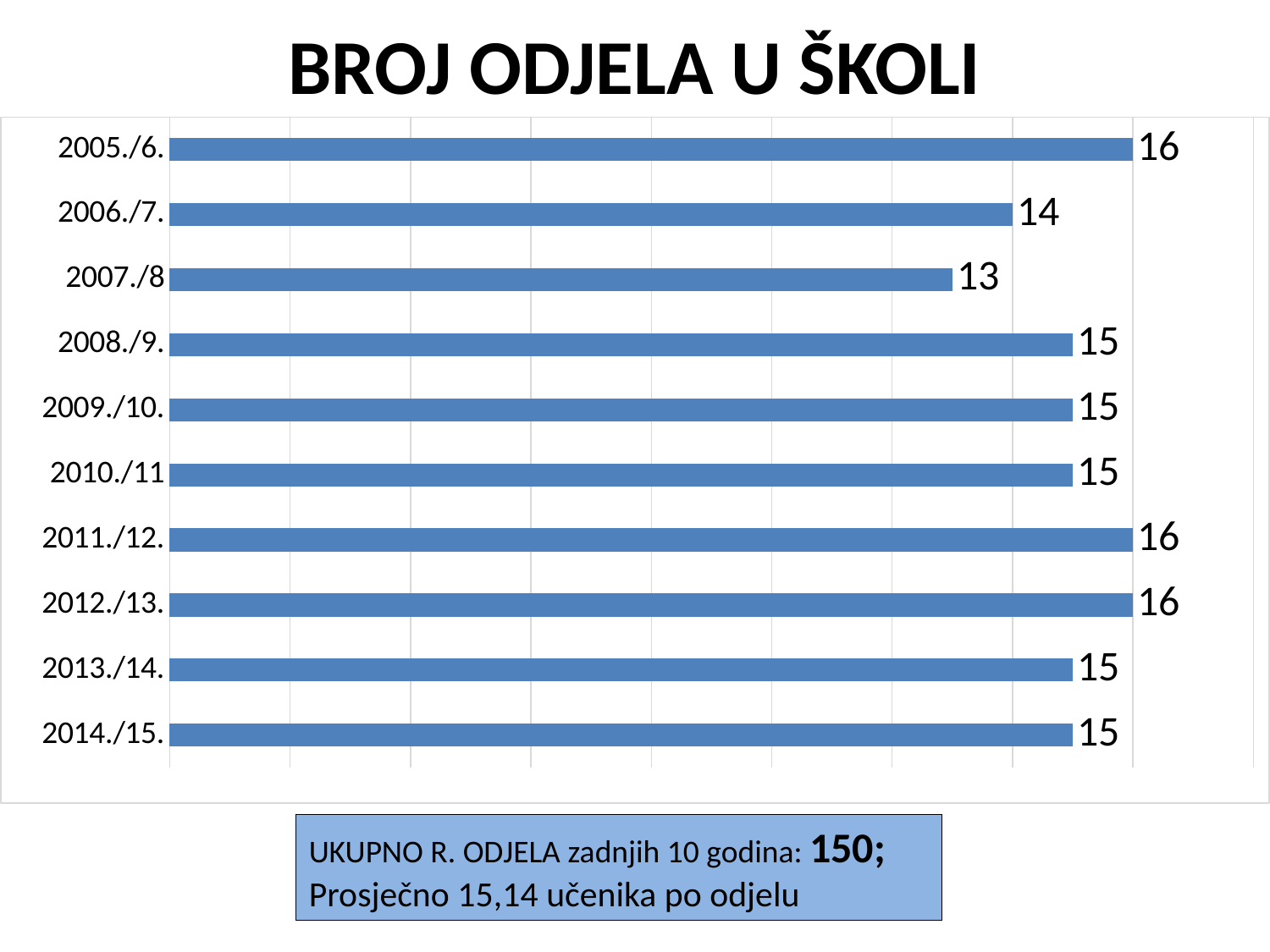
What is the difference between the values for 2006./7. and 2008./9.? 1 What is the value for 2007./8? 13 What is the value for 2014./15.? 15 Which is larger, the value for 2011./12. or the value for 2013./14.? 2011./12. What is the title of the chart? BROJ ODJELA U ŠKOLI What is the value for 2006./7.? 14 What is the value for 2005./6.? 16 Which is larger, the value for 2006./7. or the value for 2007./8? 2006./7. What is the difference between the values for 2005./6. and 2007./8? 3 What kind of chart is shown on the slide? bar chart How many categories are shown in the chart? 10 Which category has the lowest value? 2007./8